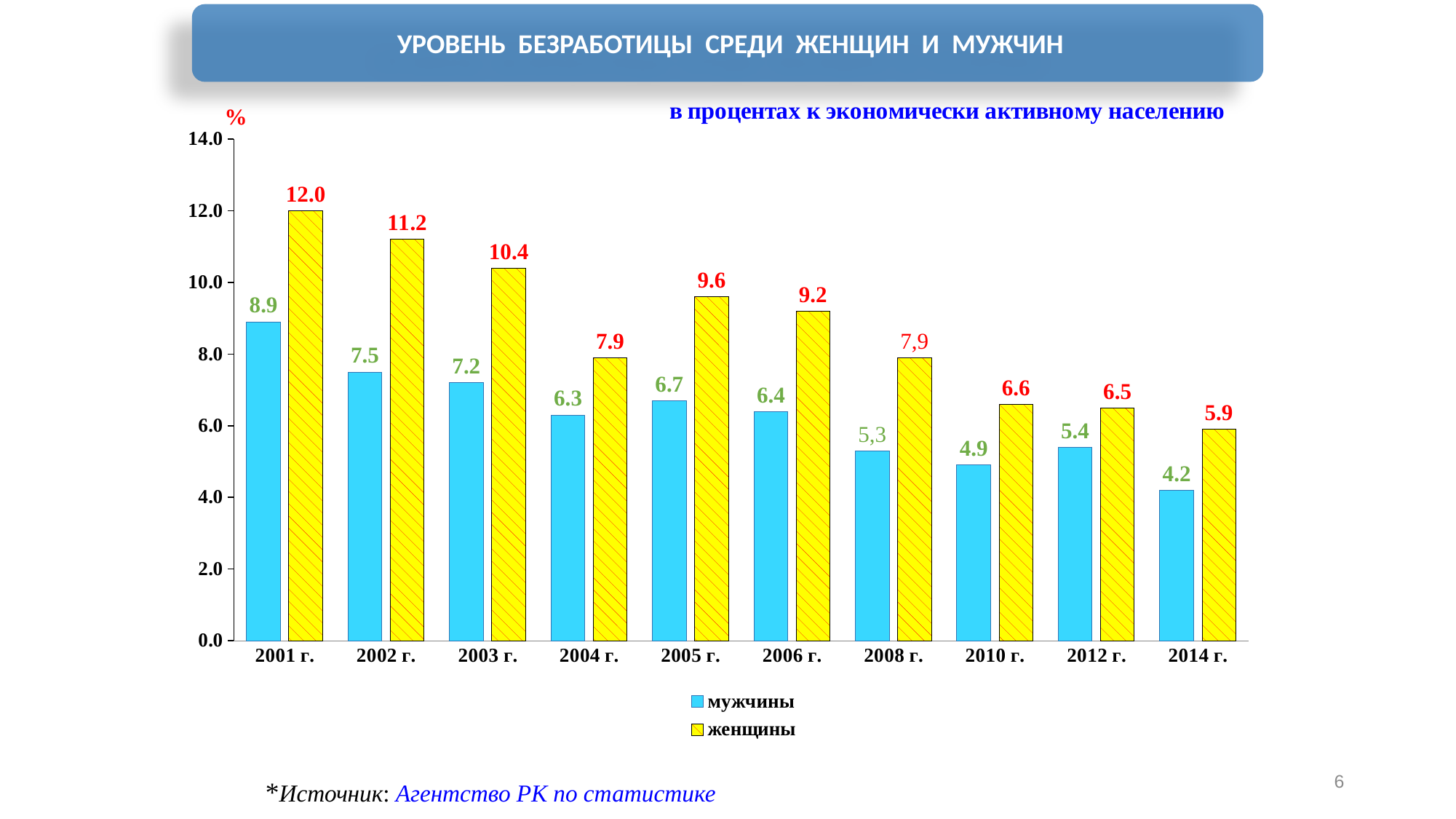
Is the value for женщины in 2014 г. greater or less than 6.0? less What is the unemployment rate for мужчины in 2001 г.? 8.9 What is the difference between the женщины and мужчины values in 2001 г.? 3.1 In which year is the unemployment rate for мужчины the lowest? 2014 г. How many years are shown on the x axis? 10 What value is shown for мужчины in 2008 г.? 5,3 What is the unemployment rate for женщины in 2003 г.? 10.4 How many series does the legend list? 2 In which year is the unemployment rate for женщины the highest? 2001 г. Does the unemployment rate for женщины generally rise or fall from 2001 г. to 2014 г.? fall What kind of chart is shown on the slide? bar chart Which is larger in 2005 г.: the value for мужчины or for женщины? женщины